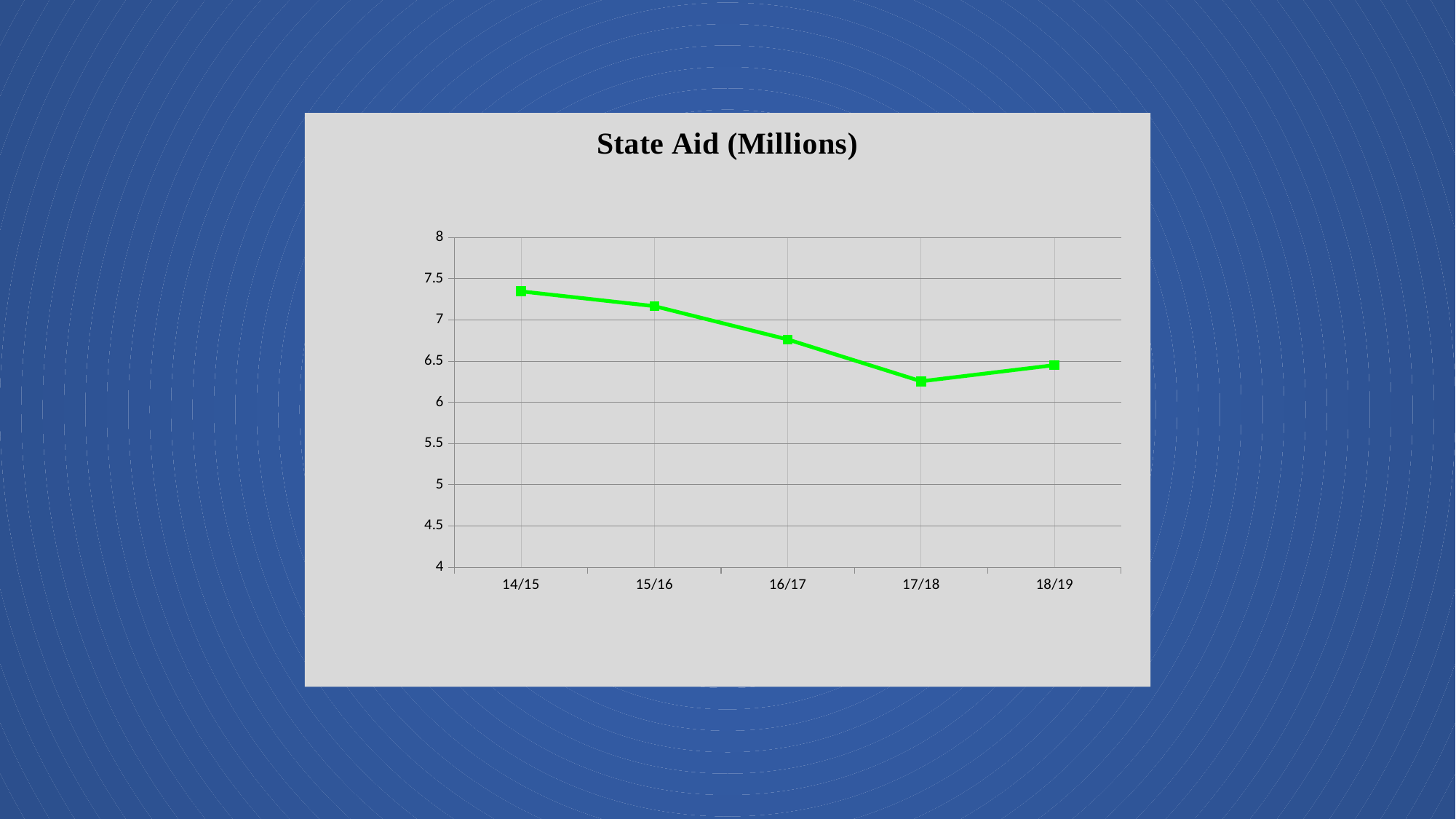
Is the value for 17/18 greater or less than 6.5? less What is the title of the chart? State Aid (Millions) Is the value for 14/15 greater or less than 7? greater What kind of chart is shown on the slide? line chart Which is larger, the value for 14/15 or the value for 18/19? 14/15 Does the State Aid value rise or fall from 14/15 to 17/18? fall Is the value for 18/19 greater or less than 6? greater Which is larger, the value for 17/18 or the value for 18/19? 18/19 Which year has the highest State Aid value? 14/15 Which year has the lowest State Aid value? 17/18 How many data points are plotted on the line? 5